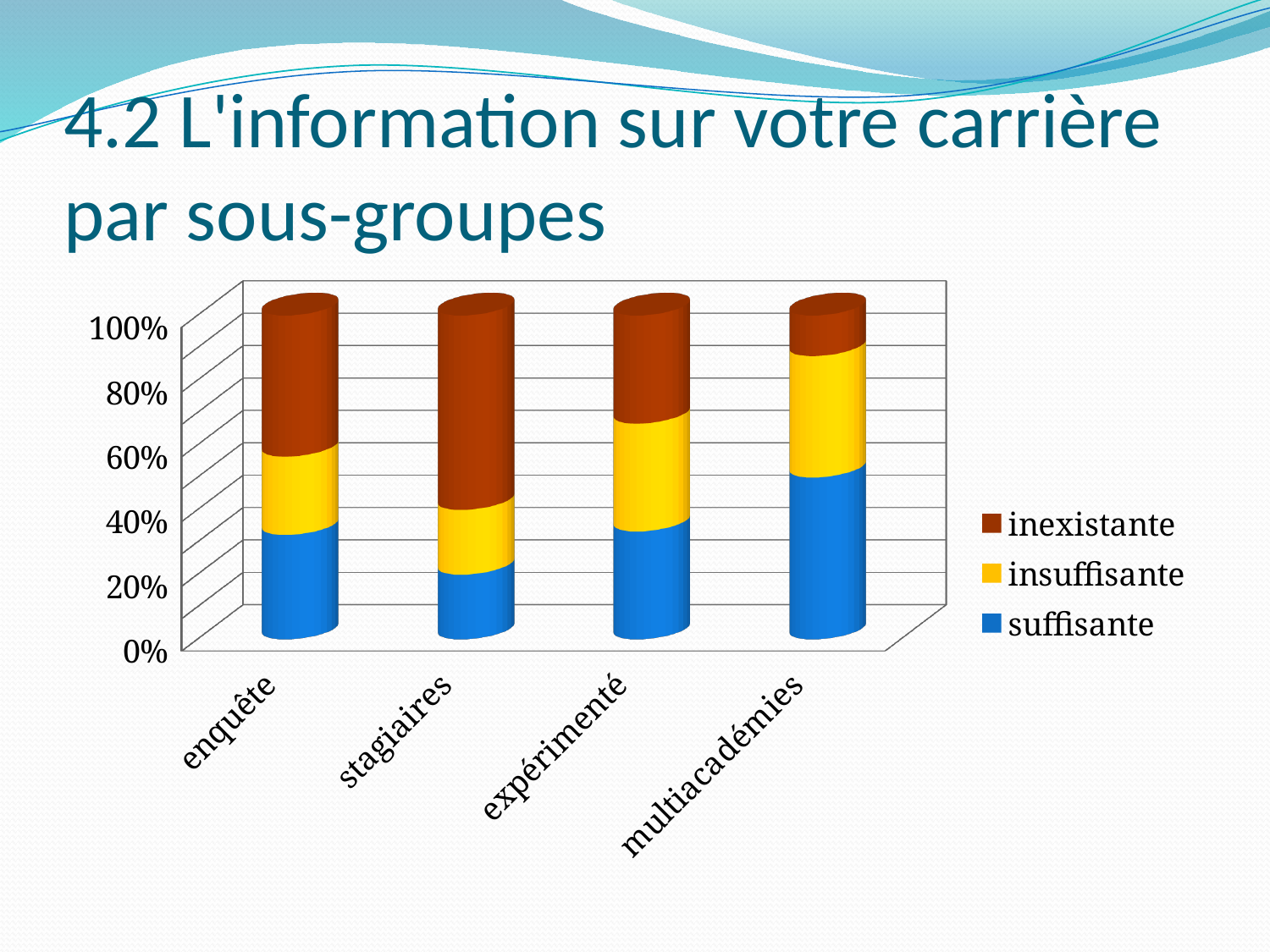
How many categories are shown on the x axis of the chart? 4 How many series does the chart legend list? 3 Is the 'inexistante' share for stagiaires greater or less than 40%? greater Which category has the smallest 'inexistante' share? multiacadémies Which colour represents the 'suffisante' series in the chart? blue Which has the larger 'suffisante' share, enquête or stagiaires? enquête Which category has the largest 'suffisante' share? multiacadémies Is the 'suffisante' share for stagiaires greater or less than 40%? less Is the 'suffisante' share for multiacadémies greater or less than 40%? greater Which category has the largest 'inexistante' share? stagiaires What kind of chart is shown on the slide? stacked bar chart Which category has the smallest 'suffisante' share? stagiaires